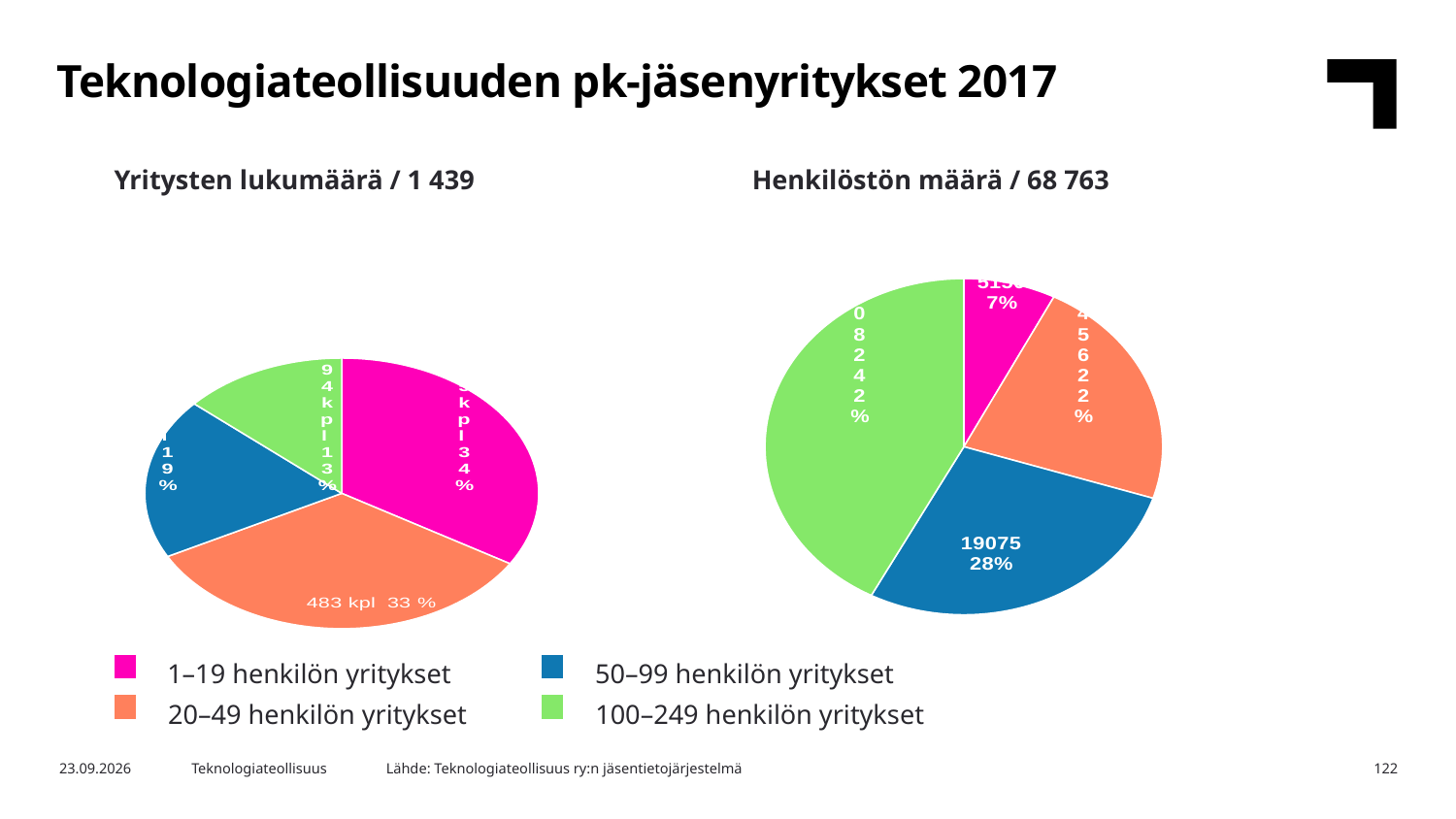
In the 'Yritysten lukumäärä / 1 439' chart, how many companies (kpl) are in the 20–49 henkilön yritykset slice? 483 kpl In the 'Henkilöstön määrä / 68 763' chart, what share of the pie is the 1–19 henkilön yritykset slice? 7% In the 'Yritysten lukumäärä / 1 439' chart, which slice is larger: 20–49 henkilön yritykset or 50–99 henkilön yritykset? 20–49 henkilön yritykset How many categories does the legend list? 4 What kind of chart is used on this slide? Pie chart In the 'Henkilöstön määrä / 68 763' chart, what share of the pie is the 50–99 henkilön yritykset slice? 28% In the 'Henkilöstön määrä / 68 763' chart, what is the value for 50–99 henkilön yritykset? 19075 In the 'Henkilöstön määrä / 68 763' chart, which category has the smallest slice? 1–19 henkilön yritykset What colour represents 100–249 henkilön yritykset in the legend? Green In the 'Yritysten lukumäärä / 1 439' chart, which category has the smallest slice? 100–249 henkilön yritykset In the 'Henkilöstön määrä / 68 763' chart, which category has the largest slice? 100–249 henkilön yritykset In the 'Yritysten lukumäärä / 1 439' chart, what share of the pie is the 20–49 henkilön yritykset slice? 33 %